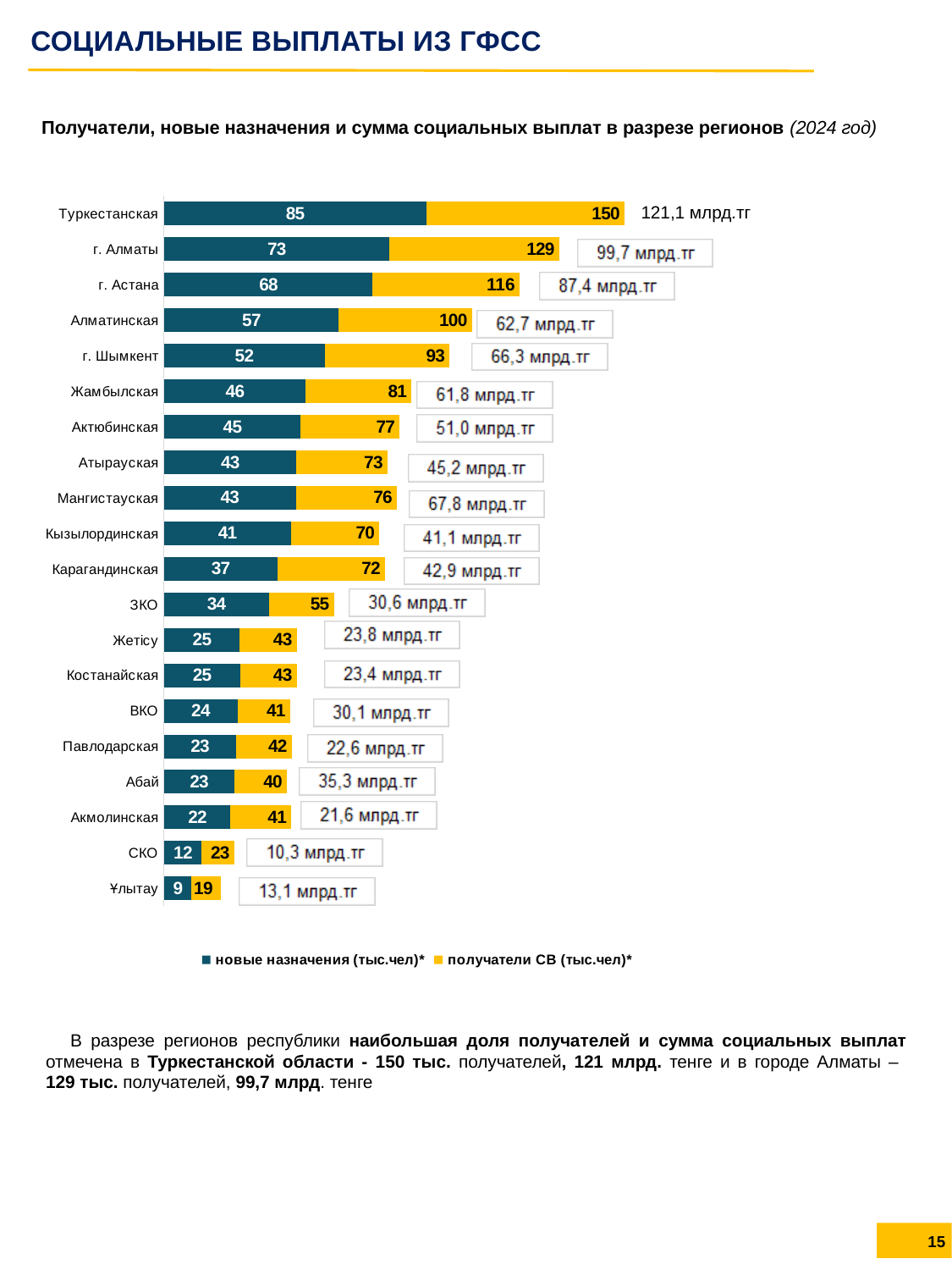
What is the value of получатели СВ (тыс.чел) for Жамбылская? 81 What kind of chart is shown on the slide? bar chart How many regions are shown on the chart? 20 Which region has the highest value of получатели СВ (тыс.чел)? Туркестанская How many series does the legend list? 2 What is the sum of social payments shown next to the bar for г. Шымкент? 66,3 млрд.тг What is the value of новые назначения (тыс.чел) for г. Астана? 68 Which colour represents получатели СВ (тыс.чел) in the legend? yellow Which region has a larger получатели СВ value, Мангистауская or Атырауская? Мангистауская What is the difference between получатели СВ and новые назначения for Актюбинская? 32 What is the difference between the получатели СВ values for Туркестанская and г. Алматы? 21 Which region has the lowest value of новые назначения (тыс.чел)? Ұлытау